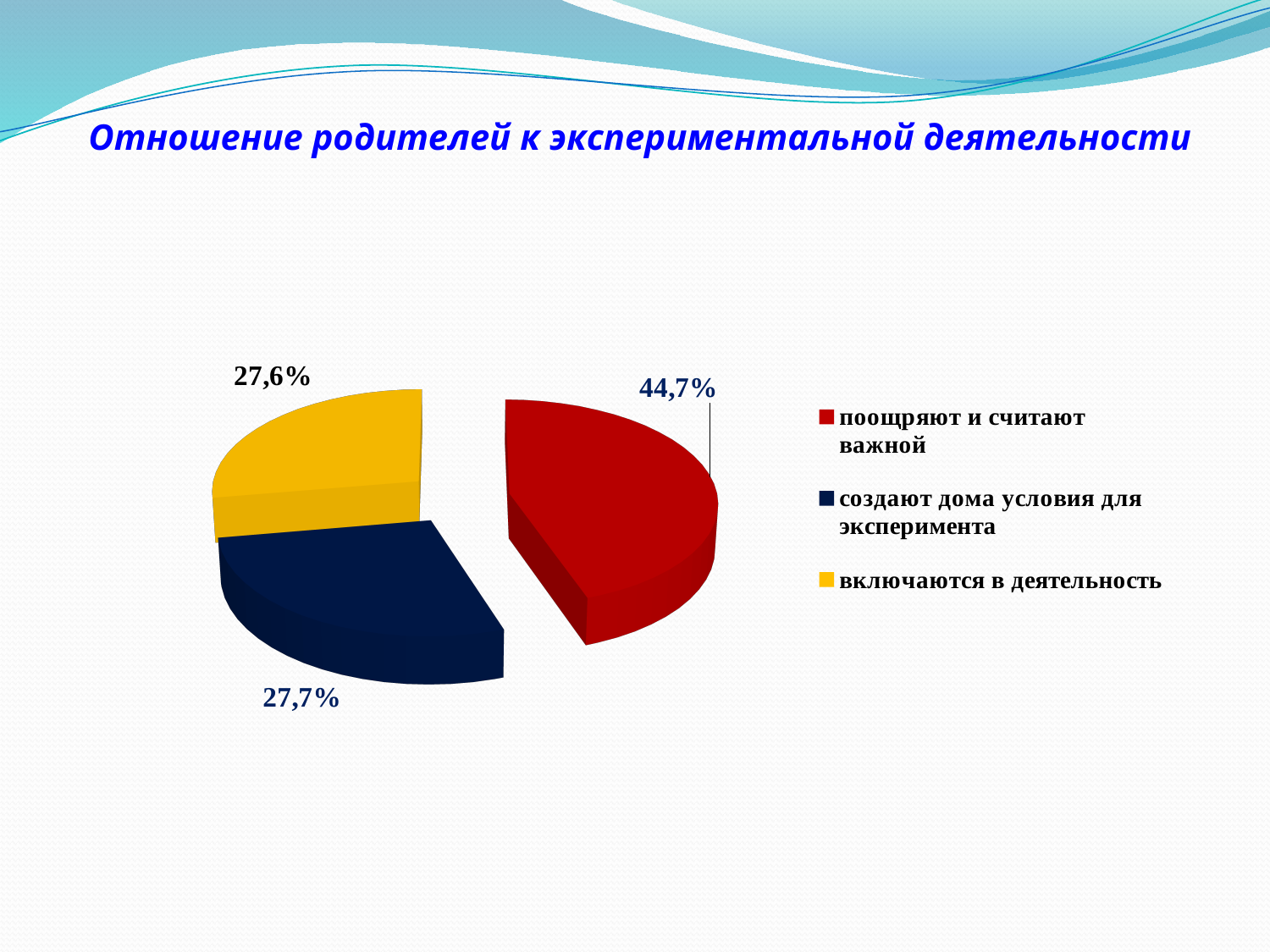
Which category has the largest slice of the pie? поощряют и считают важной What share of the pie is labelled "поощряют и считают важной"? 44,7% What colour is the slice for "включаются в деятельность"? yellow What share of the pie is labelled "создают дома условия для эксперимента"? 27,7% Which category has the smallest slice of the pie? включаются в деятельность What is the difference between the shares for "поощряют и считают важной" and "создают дома условия для эксперимента"? 17,0% What is the title of the chart on the slide? Отношение родителей к экспериментальной деятельности What share of the pie is labelled "включаются в деятельность"? 27,6% What kind of chart is shown on the slide? pie chart How many entries does the legend list? 3 Which is larger: the share for "поощряют и считают важной" or the share for "включаются в деятельность"? поощряют и считают важной How many slices does the pie chart have? 3